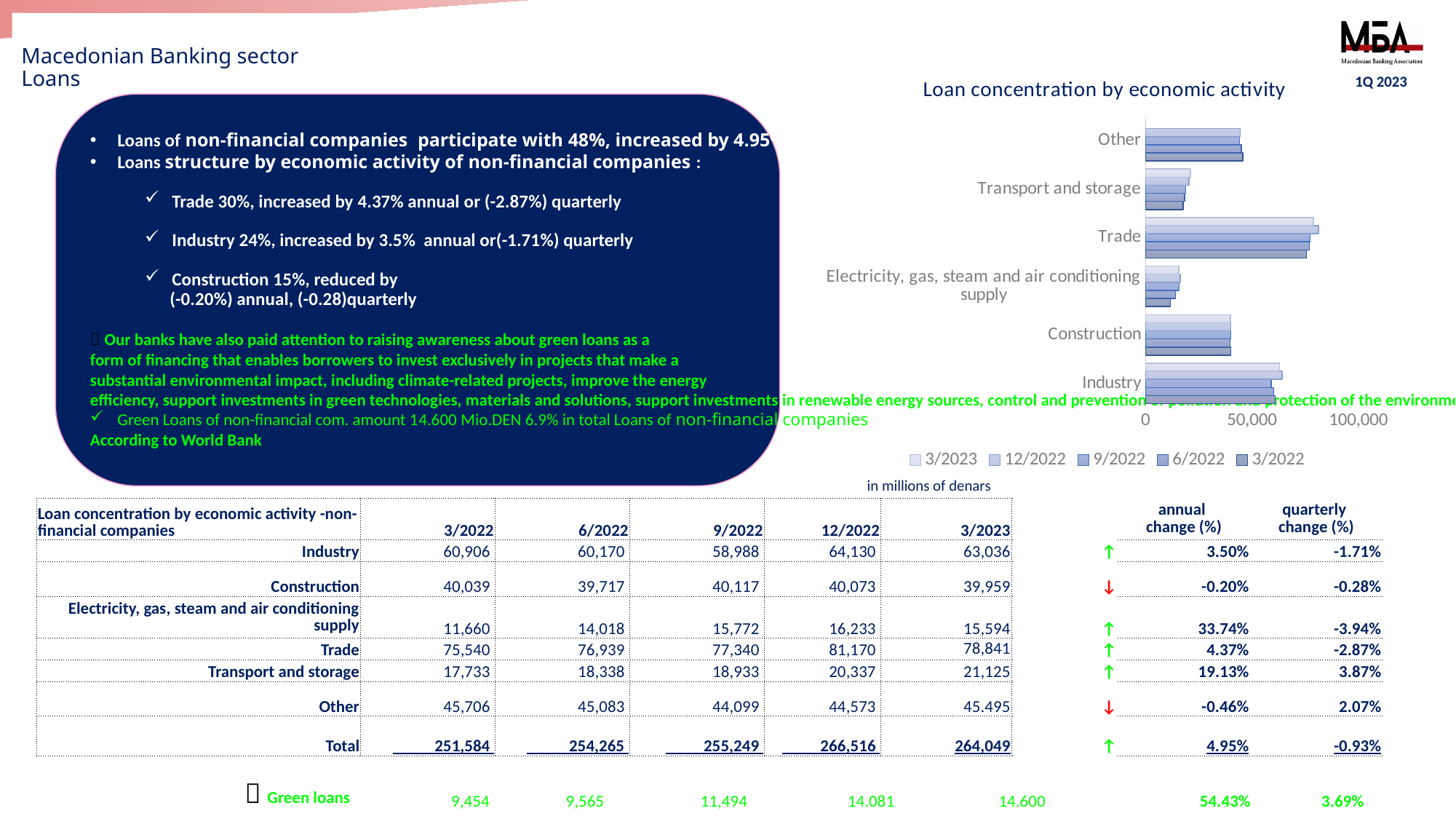
In the "Loan concentration by economic activity" chart, is the value for Construction greater or less than 50,000? less Do the Transport and storage values rise or fall from 3/2022 to 3/2023? rise What kind of chart is shown under the title "Loan concentration by economic activity"? bar chart Which category has the longest bars in the "Loan concentration by economic activity" chart? Trade How many economic activity categories are plotted in the "Loan concentration by economic activity" chart? 6 In the "Loan concentration by economic activity" chart, is the value for Trade greater or less than 50,000? greater What is the title of the bar chart on the slide? Loan concentration by economic activity In the "Loan concentration by economic activity" chart, which is larger, Industry or Construction? Industry According to the table, what is the Trade value for 3/2023? 78,841 How many series does the legend of the "Loan concentration by economic activity" chart list? 5 According to the table, what is the difference between the Industry and Construction values for 3/2023? 23,077 Which category has the shortest bars in the "Loan concentration by economic activity" chart? Electricity, gas, steam and air conditioning supply